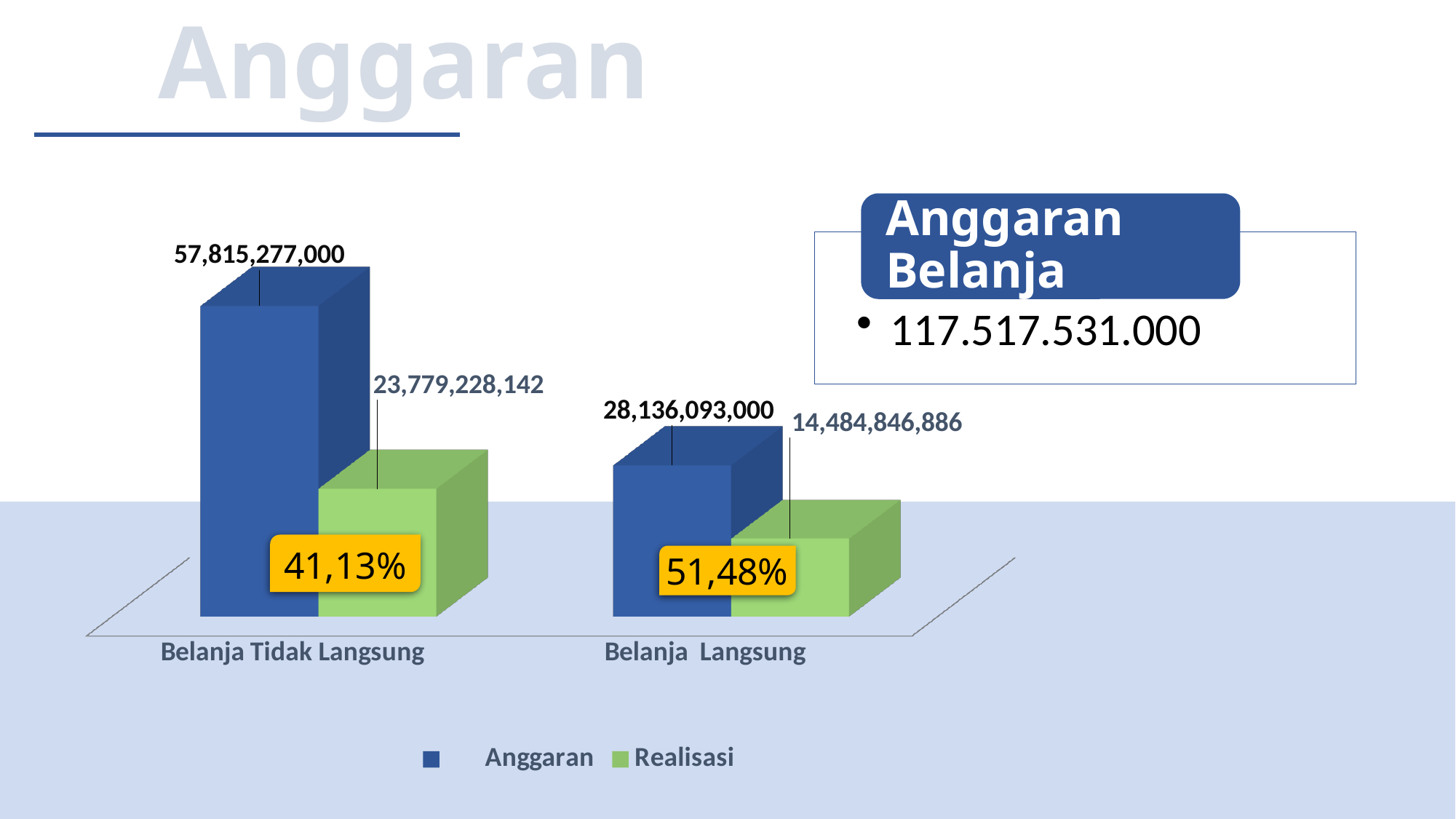
Which category has the lowest Realisasi value? Belanja Langsung What type of chart is shown on the slide? Bar chart What is the Realisasi value for Belanja Langsung? 14,484,846,886 How many categories are shown on the x axis of the chart? 2 What is the difference between the Anggaran and Realisasi values for Belanja Tidak Langsung? 34,036,048,858 Which category has the highest Anggaran value? Belanja Tidak Langsung How many series does the chart legend list? 2 What is the difference between the Anggaran values for Belanja Tidak Langsung and Belanja Langsung? 29,679,184,000 What is the Anggaran value for Belanja Tidak Langsung? 57,815,277,000 What is the Anggaran value for Belanja Langsung? 28,136,093,000 What is the Realisasi value for Belanja Tidak Langsung? 23,779,228,142 Which is larger: the Realisasi value for Belanja Tidak Langsung or the Anggaran value for Belanja Langsung? Anggaran value for Belanja Langsung